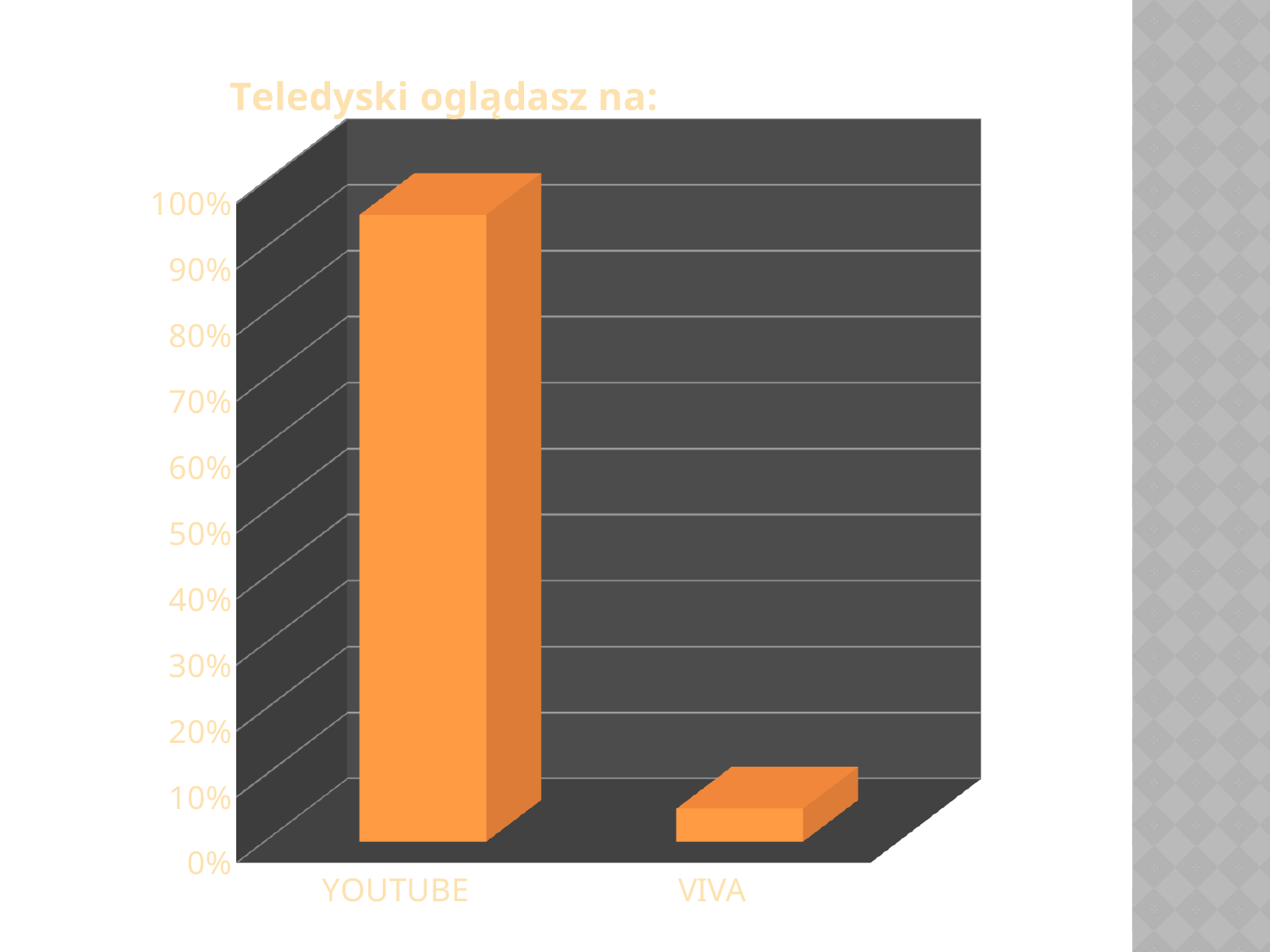
What is the title of the chart? Teledyski oglądasz na: Which category has the highest value in the chart? YOUTUBE Which category has the lowest value in the chart? VIVA Is the value for VIVA greater or less than 20%? less Is the value for YOUTUBE greater or less than 90%? greater Which is larger, the value for YOUTUBE or the value for VIVA? YOUTUBE Is the value for VIVA greater or less than 10%? less What kind of chart is shown on the slide? bar chart Do the values fall or rise from YOUTUBE to VIVA along the x axis? fall What is the highest value shown on the vertical axis of the chart? 100% How many categories are shown on the x axis of the chart? 2